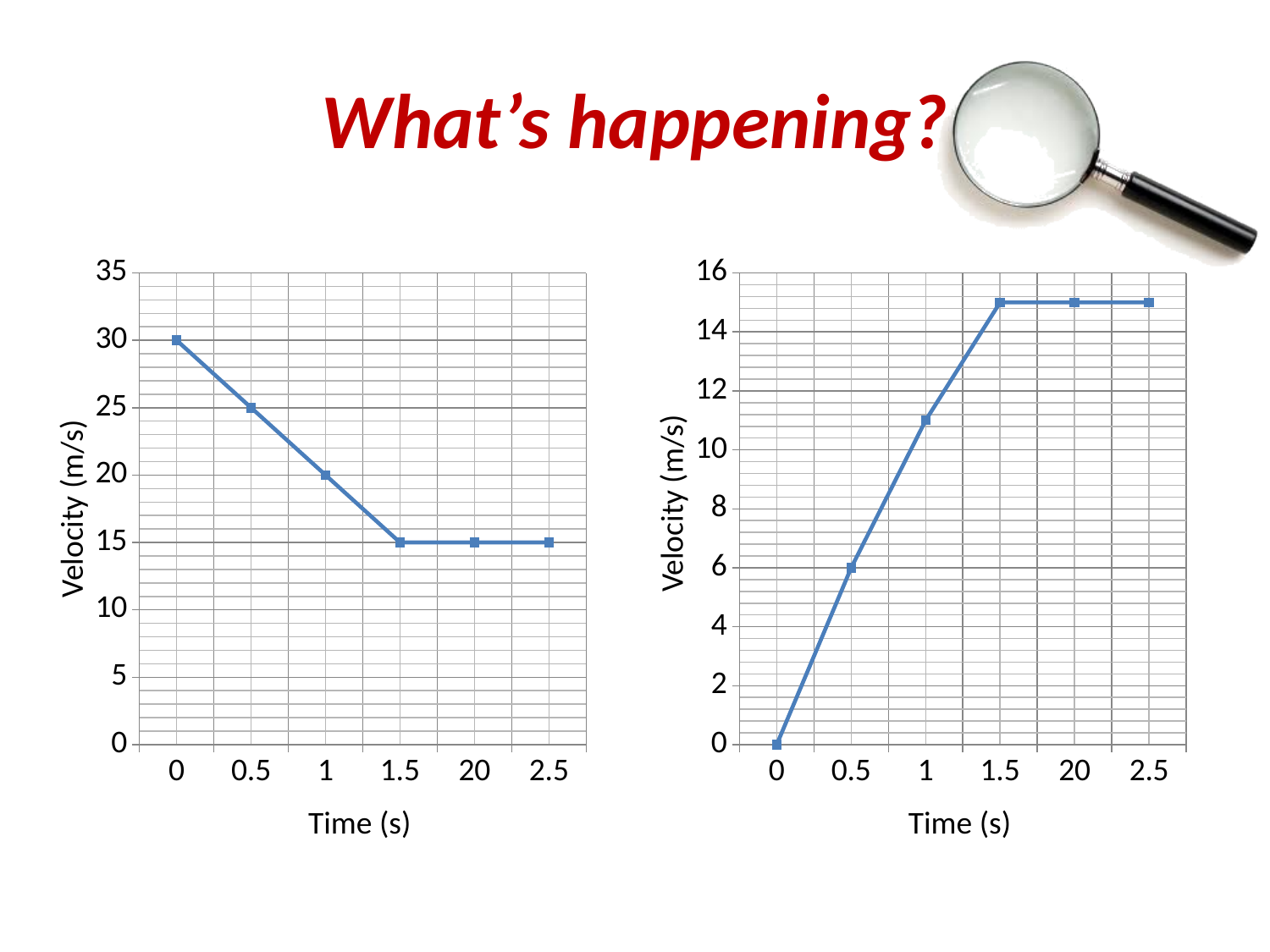
On the left chart, what is the velocity at time 0? 30 On the right chart, does the velocity rise or fall between time 0 and time 1.5? rise On the left chart, what is the velocity at time 2.5? 15 On the left chart, what is the velocity at time 1? 20 What is the label of the y axis on the right chart? Velocity (m/s) On the right chart, is the velocity at time 1 greater or less than 10? greater On the left chart, what is the difference between the velocity at time 0 and at time 1.5? 15 On the right chart, is the velocity at time 2.5 greater or less than 14? greater On the left chart, at which time is the velocity highest? 0 On the right chart, what is the velocity at time 0.5? 6 On the left chart, how many data points are plotted? 6 What type of chart is the left chart? line chart